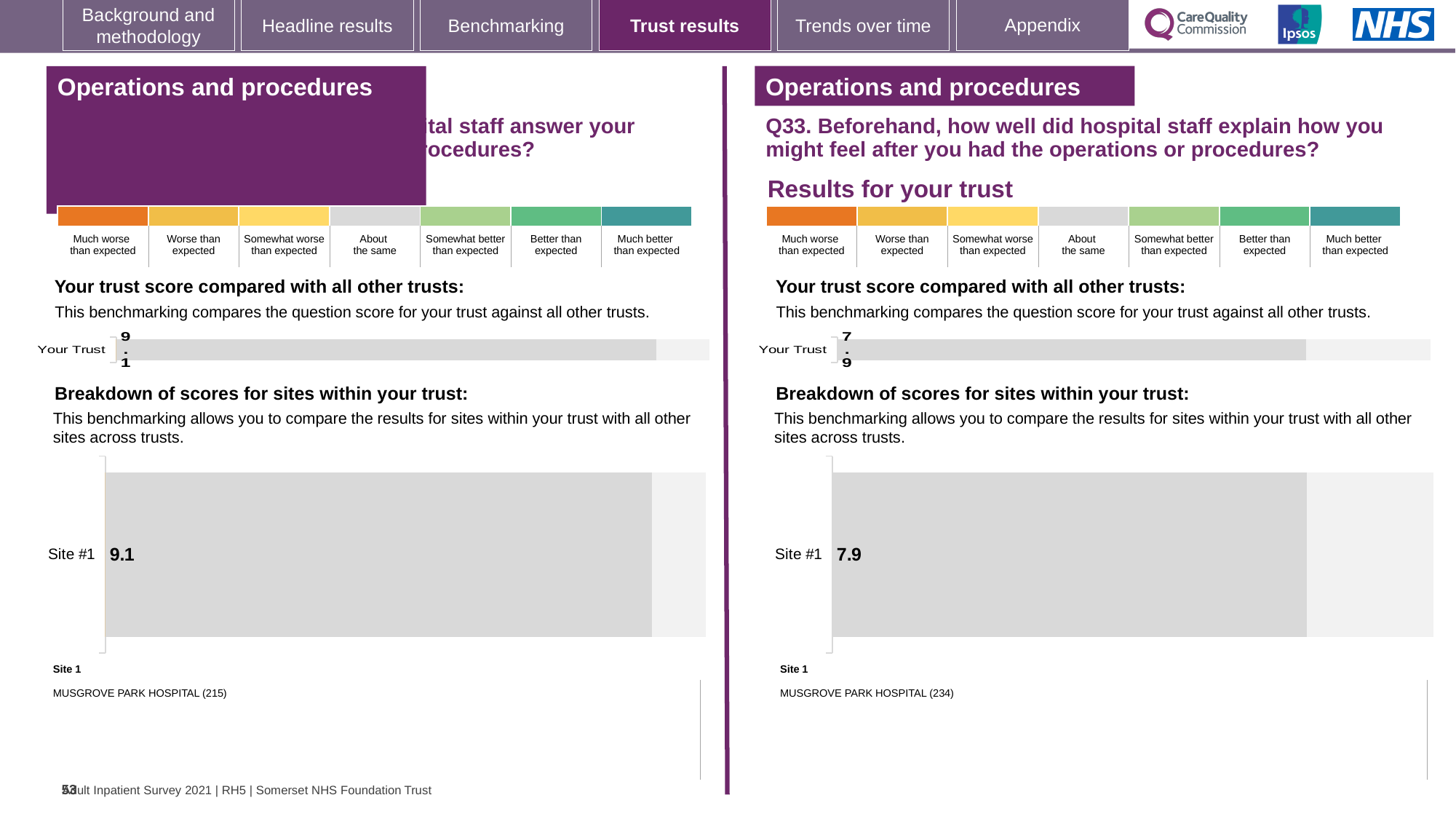
On the right panel (Q33), what is the score shown for Site #1 in the breakdown of scores for sites within your trust? 7.9 How many sites are shown in the breakdown of scores chart on the right panel (Q33)? 1 On the right panel (Q33), is the Your Trust score equal to the Site #1 score? Yes, both are 7.9 On the left panel, which hospital is listed as Site 1 below the breakdown chart? MUSGROVE PARK HOSPITAL (215) Which is larger: the Site #1 score on the left panel or the Site #1 score on the right panel (Q33)? Left panel (9.1) On the right panel (Q33), what is the value shown for Your Trust in the trust score chart? 7.9 On the left panel, what is the value shown for Your Trust in the trust score chart? 9.1 What type of chart is used to show the Site #1 score on the right panel (Q33)? Bar chart What is the difference between the Site #1 score on the left panel and the Site #1 score on the right panel (Q33)? 1.2 On the left panel, what is the score shown for Site #1 in the breakdown of scores for sites within your trust? 9.1 How many sites are shown in the breakdown of scores chart on the left panel? 1 On the right panel (Q33), which hospital is listed as Site 1 below the breakdown chart? MUSGROVE PARK HOSPITAL (234)